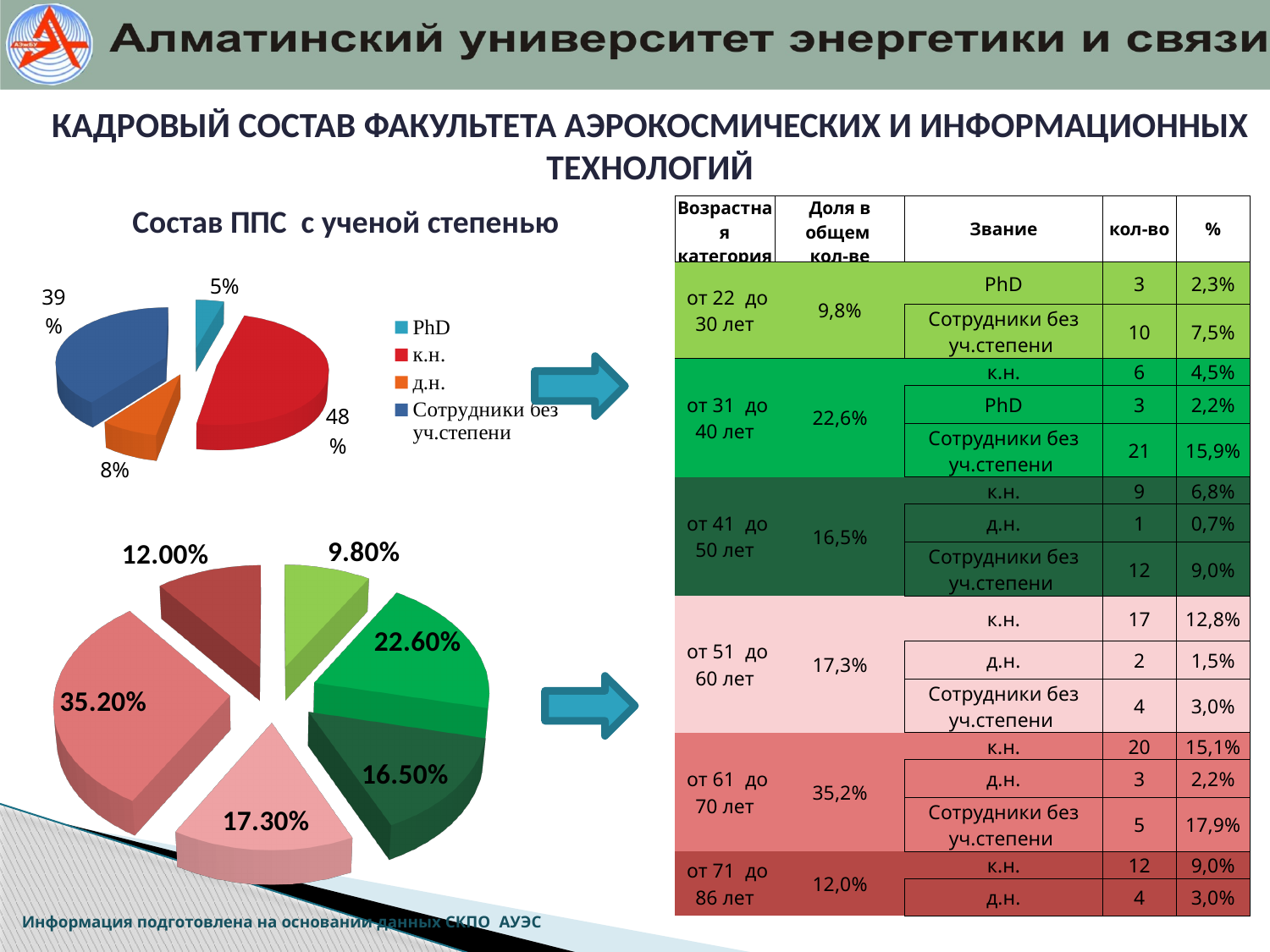
In the pie chart titled 'Состав ППС с ученой степенью', what share is shown for Сотрудники без уч.степени? 39% In the pie chart titled 'Состав ППС с ученой степенью', which category has the largest share? к.н. In the pie chart titled 'Состав ППС с ученой степенью', which is larger: д.н. or PhD? д.н. In the pie chart titled 'Состав ППС с ученой степенью', which category has the smallest share? PhD In the pie chart titled 'Состав ППС с ученой степенью', what share is shown for д.н.? 8% In the pie chart titled 'Состав ППС с ученой степенью', what share is shown for PhD? 5% How many slices does the lower pie chart on the left of the slide have? 6 What type of chart is the upper chart on the left of the slide? Pie chart In the pie chart titled 'Состав ППС с ученой степенью', by how many percentage points does к.н. exceed Сотрудники без уч.степени? 9 In the pie chart titled 'Состав ППС с ученой степенью', what share is shown for к.н.? 48% How many entries does the legend of the pie chart titled 'Состав ППС с ученой степенью' list? 4 In the lower pie chart on the left of the slide, what is the value of the largest slice? 35.20%